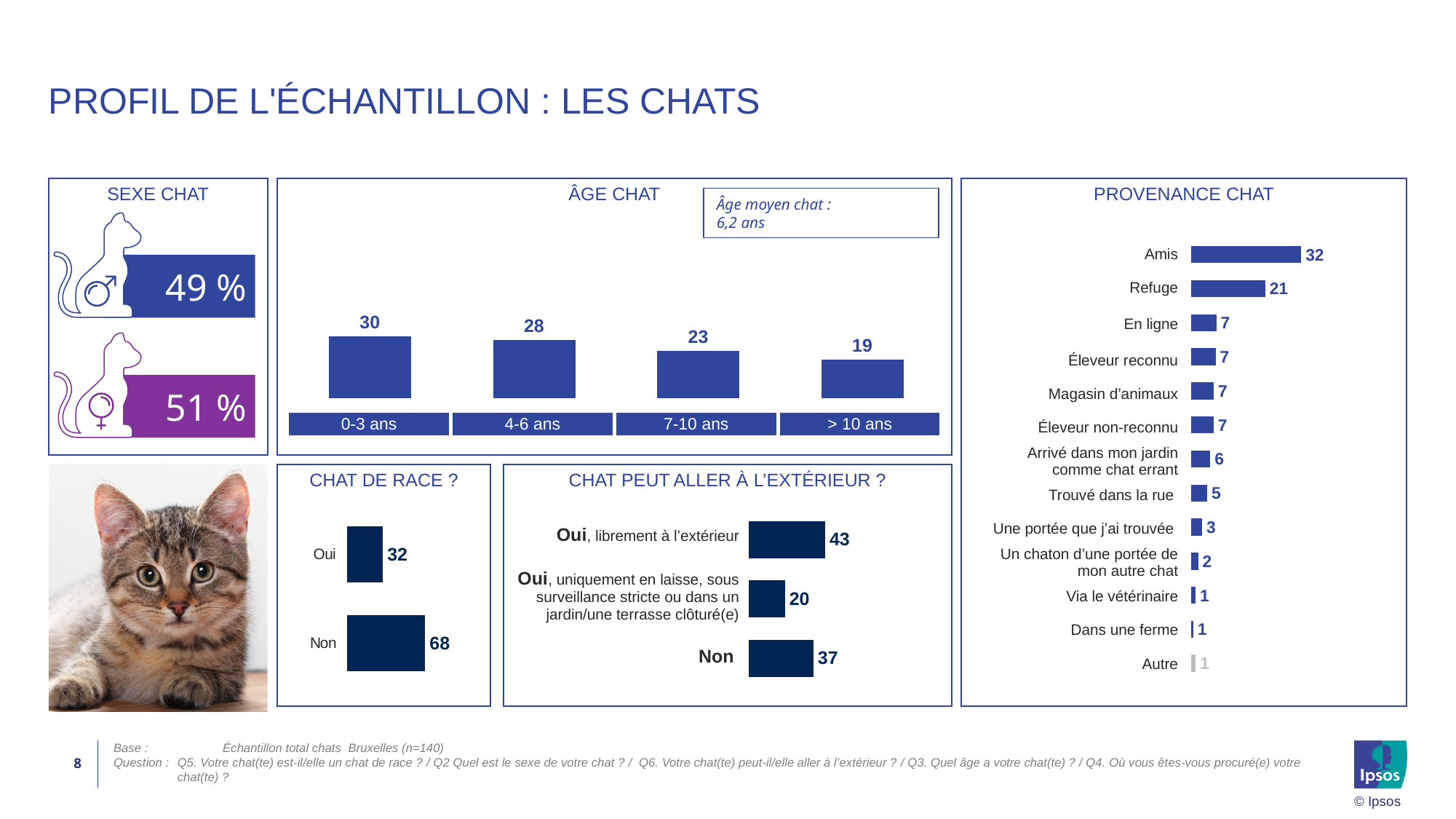
In the PROVENANCE CHAT chart, how many categories are shown? 13 In the ÂGE CHAT chart, do the values rise or fall from 0-3 ans to > 10 ans? fall What kind of chart is the PROVENANCE CHAT chart? bar chart In the ÂGE CHAT chart, what is the difference between 0-3 ans and 7-10 ans? 7 In the PROVENANCE CHAT chart, what is the value for Refuge? 21 In the CHAT PEUT ALLER À L'EXTÉRIEUR ? chart, what is the value for 'Oui, uniquement en laisse, sous surveillance stricte ou dans un jardin/une terrasse clôturé(e)'? 20 In the ÂGE CHAT chart, what is the value for 0-3 ans? 30 In the CHAT DE RACE ? chart, what is the value for Non? 68 In the ÂGE CHAT chart, which age category has the lowest value? > 10 ans In the PROVENANCE CHAT chart, which category has the highest value? Amis In the CHAT PEUT ALLER À L'EXTÉRIEUR ? chart, which is larger: 'Oui, librement à l'extérieur' or 'Non'? Oui, librement à l'extérieur In the PROVENANCE CHAT chart, what is the difference between Amis and Refuge? 11